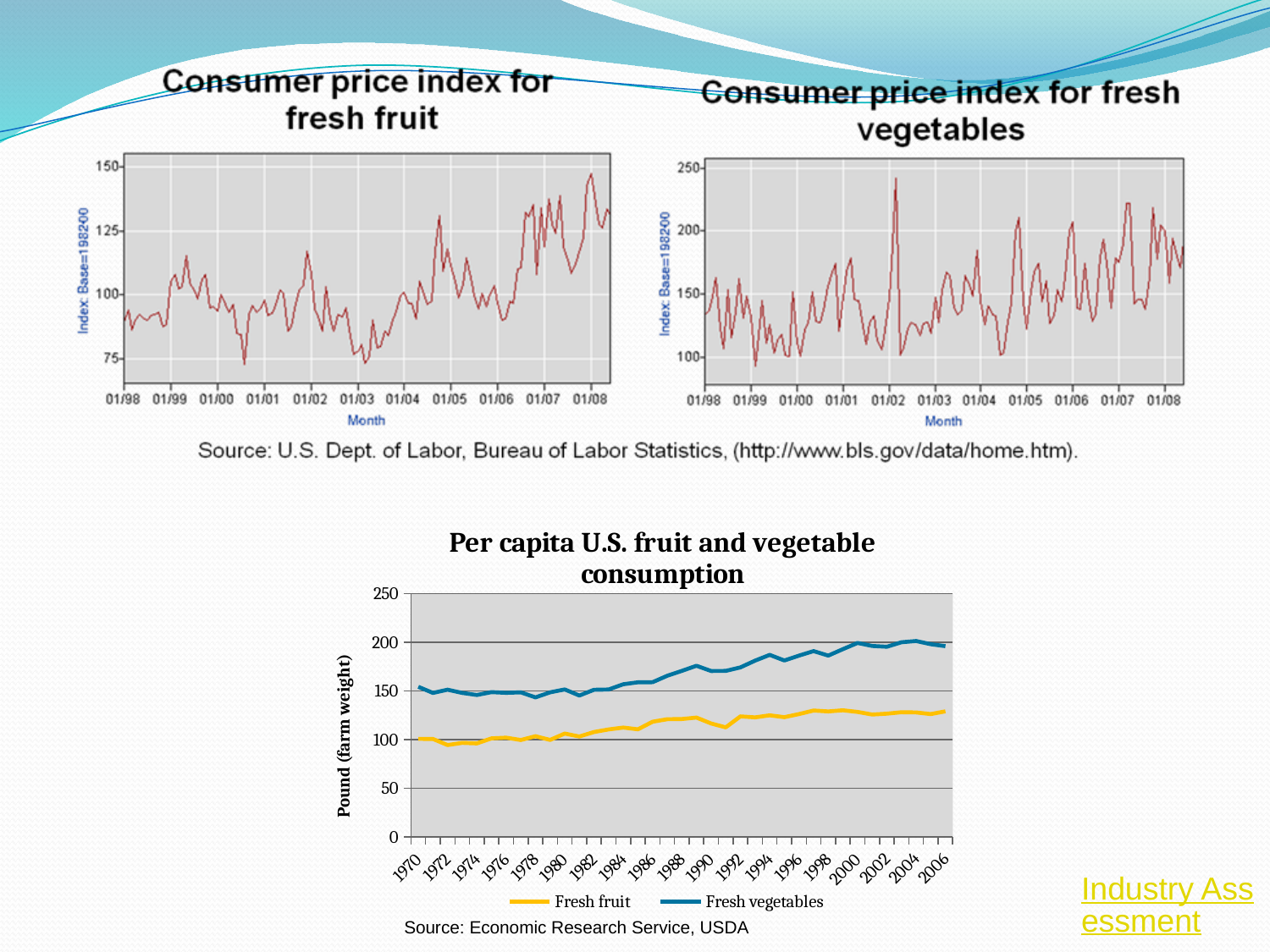
What are the two series named in the legend of the "Per capita U.S. fruit and vegetable consumption" chart? Fresh fruit and Fresh vegetables In the "Consumer price index for fresh fruit" chart, is the highest peak (near 01/08) greater or less than 125? greater In the "Per capita U.S. fruit and vegetable consumption" chart, is the value for Fresh fruit in 2006 greater or less than 150? less In the "Per capita U.S. fruit and vegetable consumption" chart, is the value for Fresh fruit in 1970 greater or less than 150? less In the "Per capita U.S. fruit and vegetable consumption" chart, does the Fresh vegetables series rise or fall from 1970 to 2006? rise In the "Per capita U.S. fruit and vegetable consumption" chart, which series is higher in 2006, Fresh fruit or Fresh vegetables? Fresh vegetables How many series does the legend of the "Per capita U.S. fruit and vegetable consumption" chart list? 2 What kind of chart is the "Per capita U.S. fruit and vegetable consumption" chart? line chart What is the y-axis title of the "Per capita U.S. fruit and vegetable consumption" chart? Pound (farm weight) What kind of chart is the "Consumer price index for fresh fruit" chart? line chart